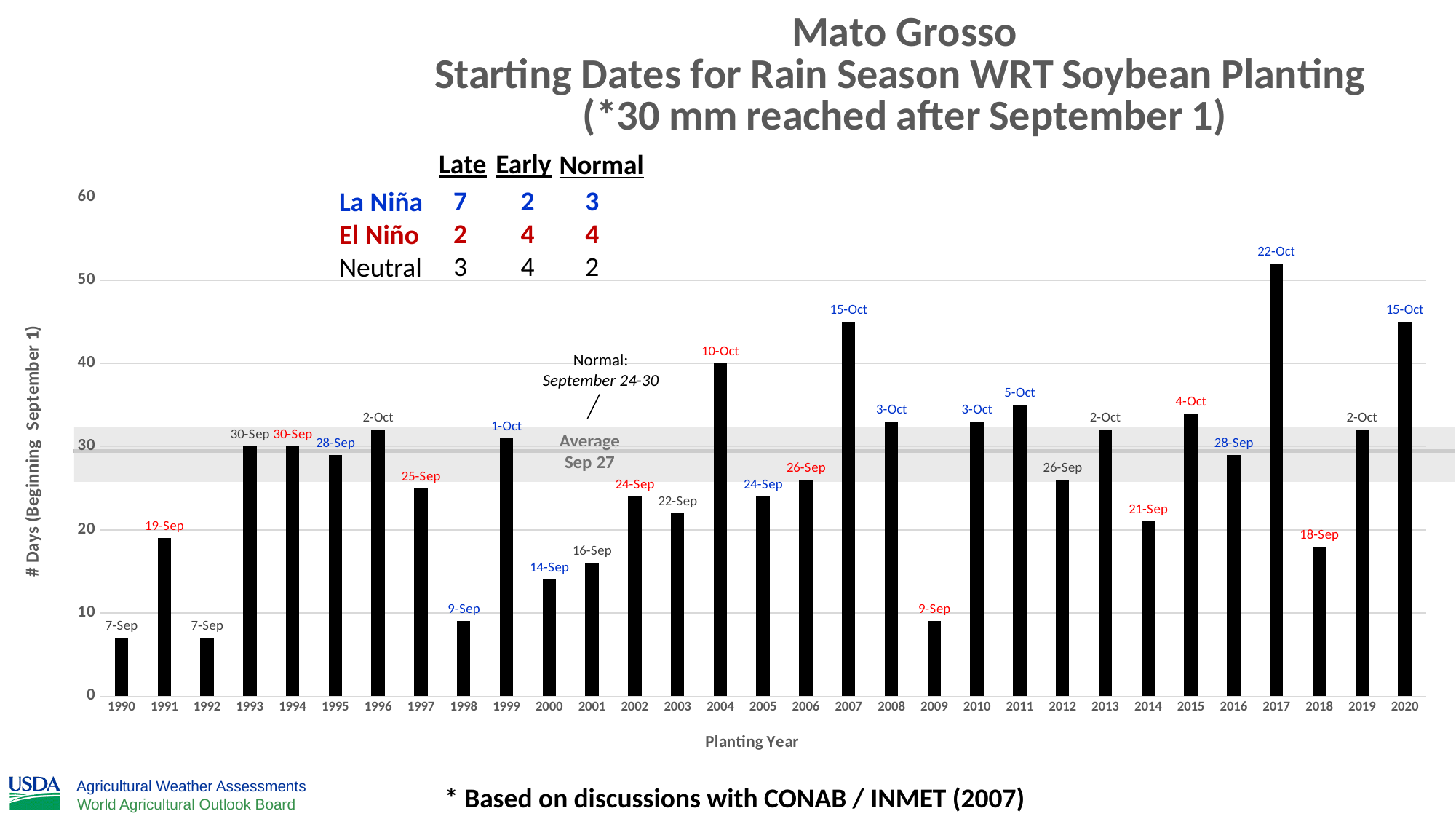
What date label is shown on the bar for 1998? 9-Sep Which has the taller bar, 2004 or 2005? 2004 Which planting years have the shortest bars? 1990 and 1992 What date label is shown on the bar for 2020? 15-Oct Is the value for 2007 greater or less than 40? greater What kind of chart is shown on the slide? bar chart What average date is marked by the horizontal line on the chart? Sep 27 Is the value for 2012 greater or less than 30? less Is the value for 2009 greater or less than 10? less What date label is shown on the bar for 2017? 22-Oct How many planting years are shown on the x axis? 31 Which planting year has the tallest bar? 2017